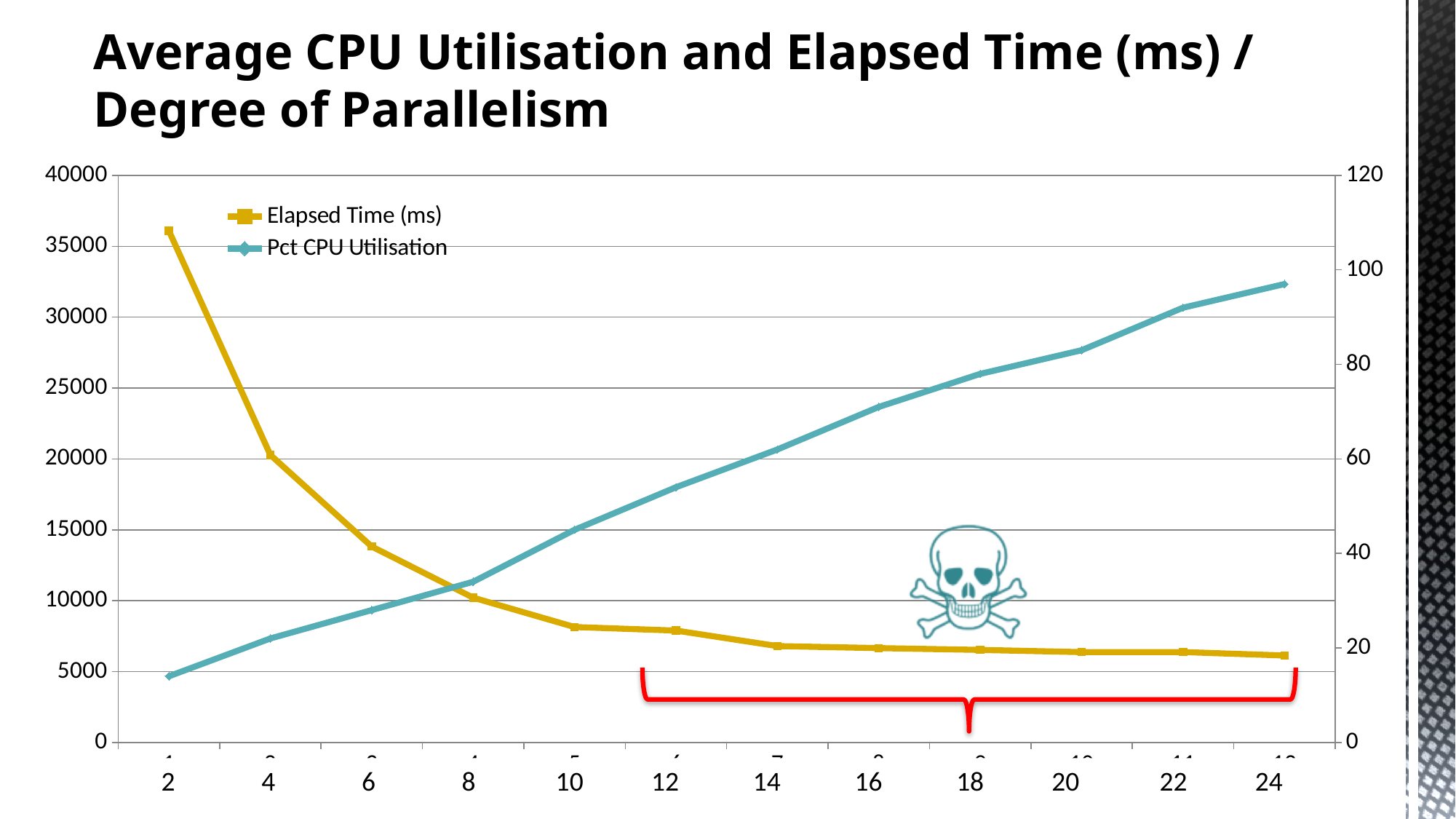
How many degree-of-parallelism points are plotted along the x axis? 12 What kind of chart is shown on the slide? line chart How many series does the legend list? 2 Is the Elapsed Time (ms) value at degree of parallelism 2 greater or less than 30000? greater At which degree of parallelism is Elapsed Time (ms) highest? 2 Is the Pct CPU Utilisation value at degree of parallelism 24 greater or less than 80? greater At which degree of parallelism is Pct CPU Utilisation highest? 24 At which degree of parallelism is Pct CPU Utilisation lowest? 2 Is the Elapsed Time (ms) value at degree of parallelism 4 greater or less than 25000? less Does Elapsed Time (ms) rise or fall as the degree of parallelism increases? fall Which is larger: Elapsed Time (ms) at degree of parallelism 6 or at degree of parallelism 10? 6 Does Pct CPU Utilisation rise or fall as the degree of parallelism increases? rise